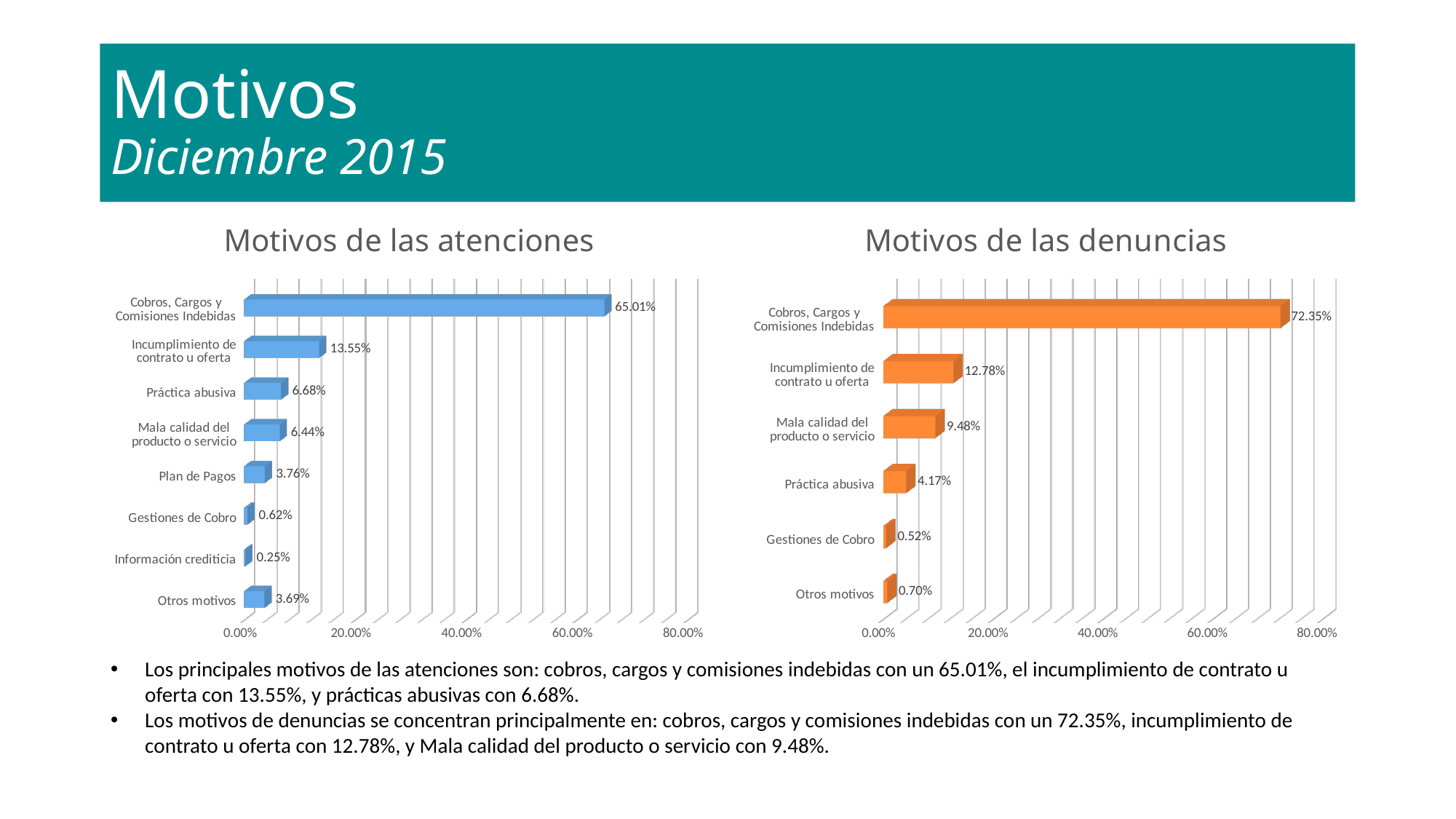
In the 'Motivos de las denuncias' chart, what is the value for Mala calidad del producto o servicio? 9.48% In the 'Motivos de las atenciones' chart, which category has the lowest value? Información crediticia What colour are the bars in the 'Motivos de las atenciones' chart? Blue What type of chart is 'Motivos de las denuncias'? Bar chart In the 'Motivos de las denuncias' chart, is the value for Cobros, Cargos y Comisiones Indebidas greater or less than 60.00%? greater How many categories are shown in the 'Motivos de las atenciones' chart? 8 In the 'Motivos de las denuncias' chart, which category has the lowest value? Gestiones de Cobro In the 'Motivos de las atenciones' chart, what is the value for Incumplimiento de contrato u oferta? 13.55% In the 'Motivos de las atenciones' chart, which category has the highest value? Cobros, Cargos y Comisiones Indebidas In the 'Motivos de las denuncias' chart, what is the difference between Cobros, Cargos y Comisiones Indebidas and Incumplimiento de contrato u oferta? 59.57% How many categories are shown in the 'Motivos de las denuncias' chart? 6 In the 'Motivos de las atenciones' chart, which is larger: Plan de Pagos or Otros motivos? Plan de Pagos